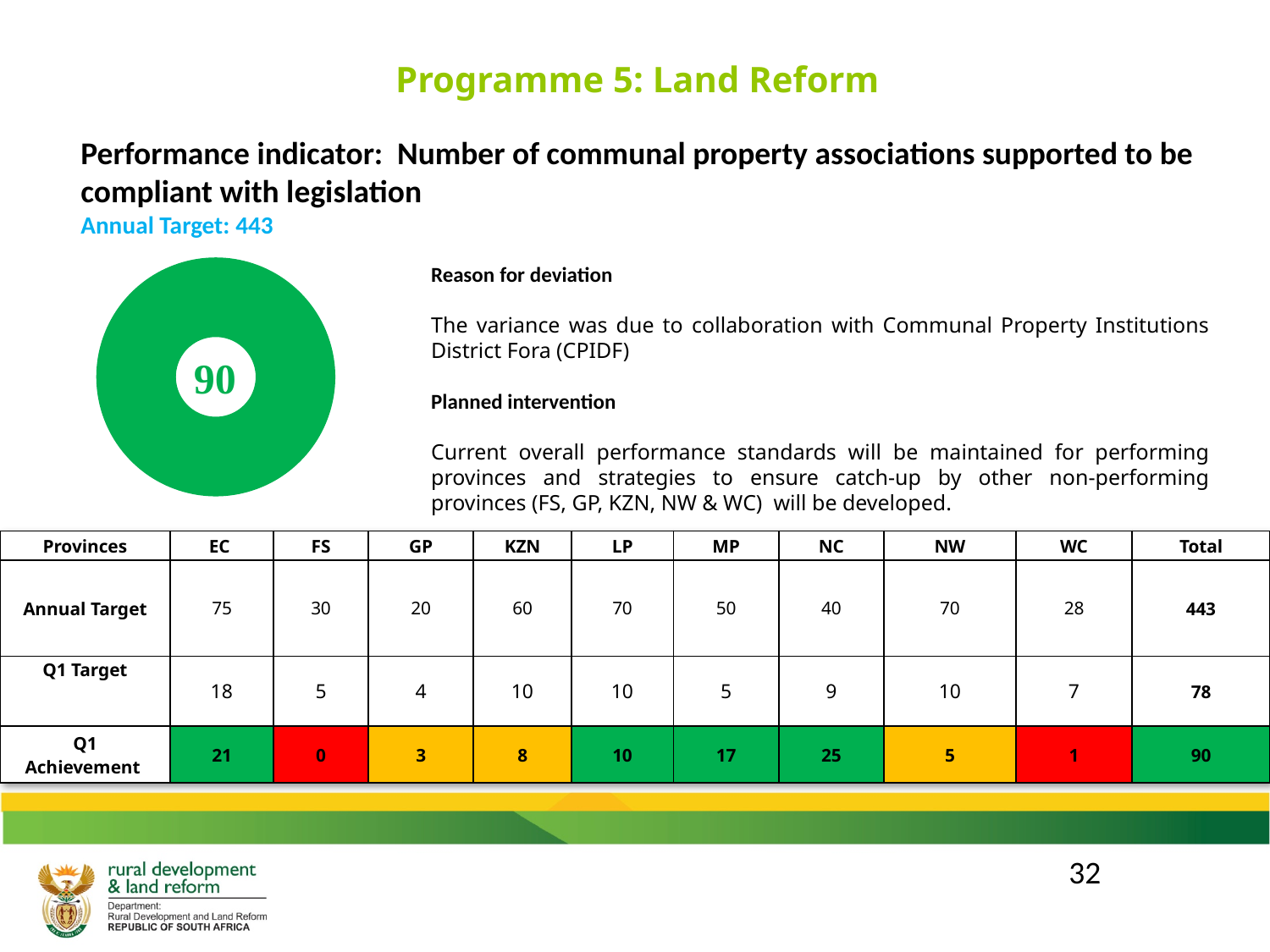
How many distinct segments are visible in the doughnut chart? 1 What number is displayed in the centre of the doughnut chart? 90 Does the doughnut chart display a legend? No What kind of chart is shown on the left of the slide? doughnut chart What colour is the ring of the doughnut chart? green Is the value shown in the centre of the doughnut chart greater or less than 50? greater